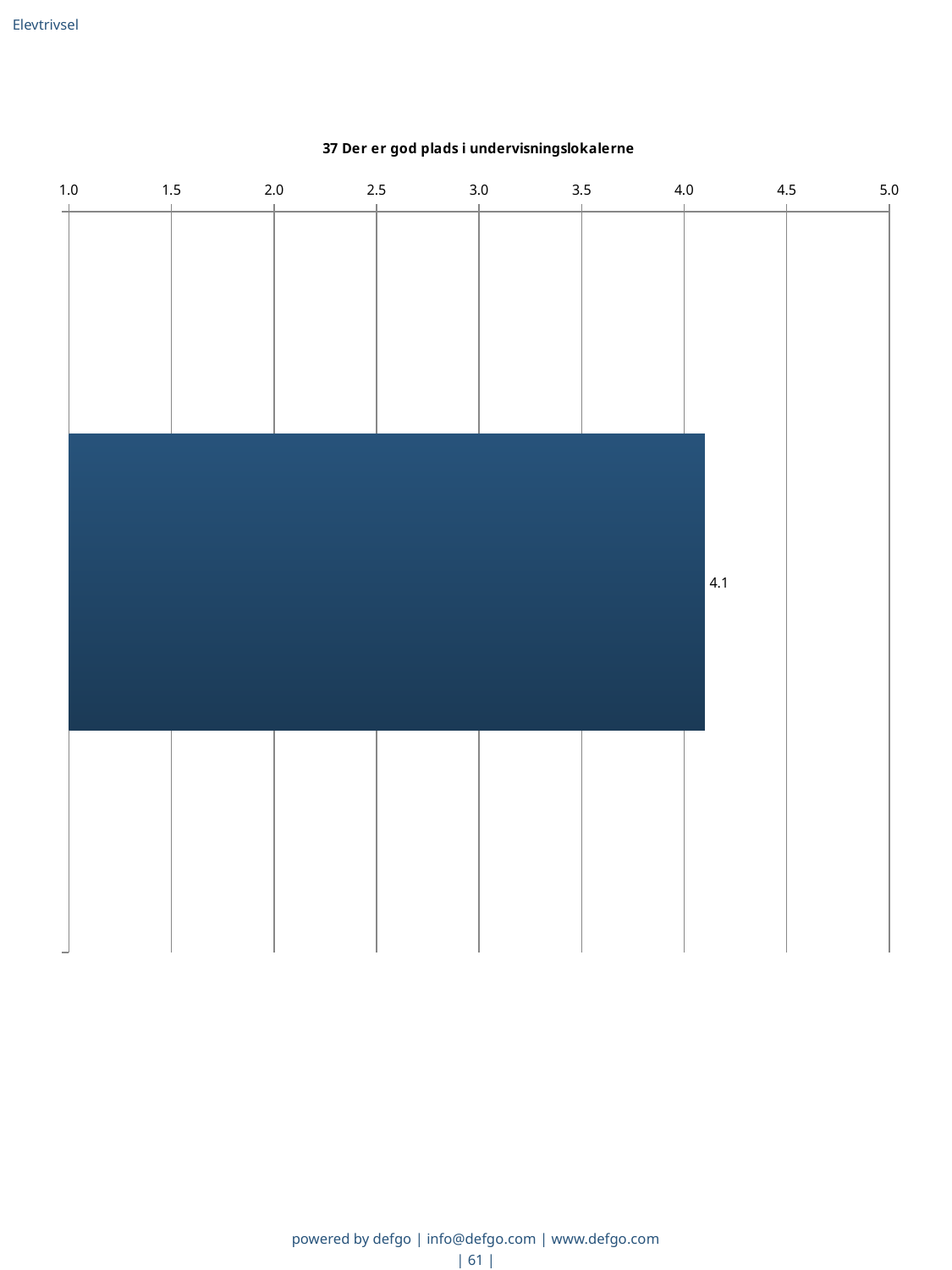
What kind of chart is shown on the slide? bar chart Is the value of the bar greater or less than 3.0? greater What value is shown by the data label on the bar in the chart? 4.1 Is the value of the bar greater or less than 4.5? less What is the highest value shown on the chart's value axis? 5.0 How many bars are plotted in the chart? 1 What is the title of the chart? 37 Der er god plads i undervisningslokalerne Is the value of the bar greater or less than 4.0? greater